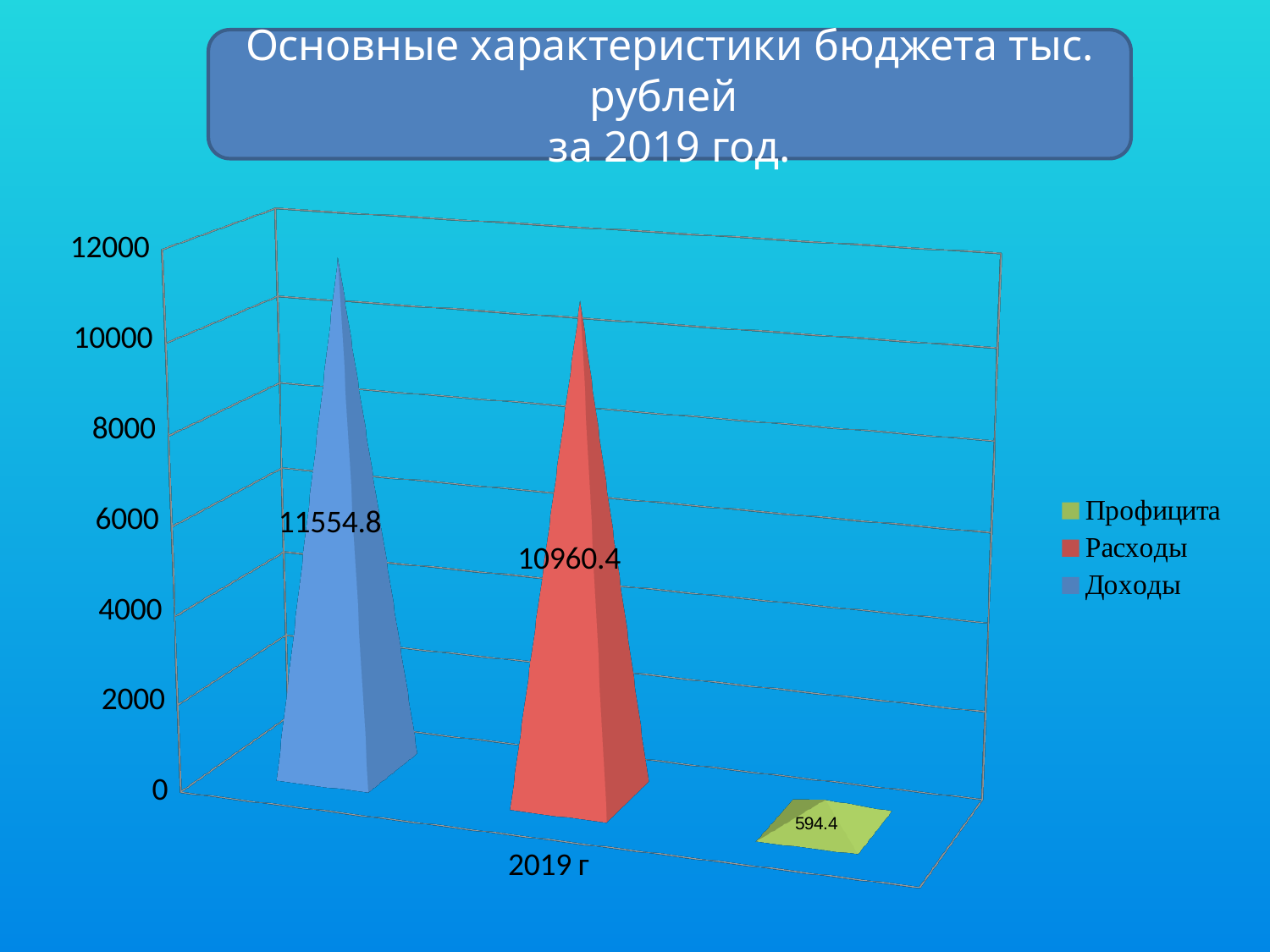
What is the difference between Доходы and Расходы? 594.4 What is the value for Расходы in 2019 г? 10960.4 Is the value for Расходы greater or less than 10000? greater What is the value for Доходы in 2019 г? 11554.8 How many categories are shown on the x axis? 1 What kind of chart is shown on the slide? bar chart What colour represents Расходы in the legend? red Which series has the lowest value? Профицита Which series has the highest value? Доходы How many series does the legend list? 3 What is the value for Профицита in 2019 г? 594.4 Which is larger, Доходы or Расходы? Доходы